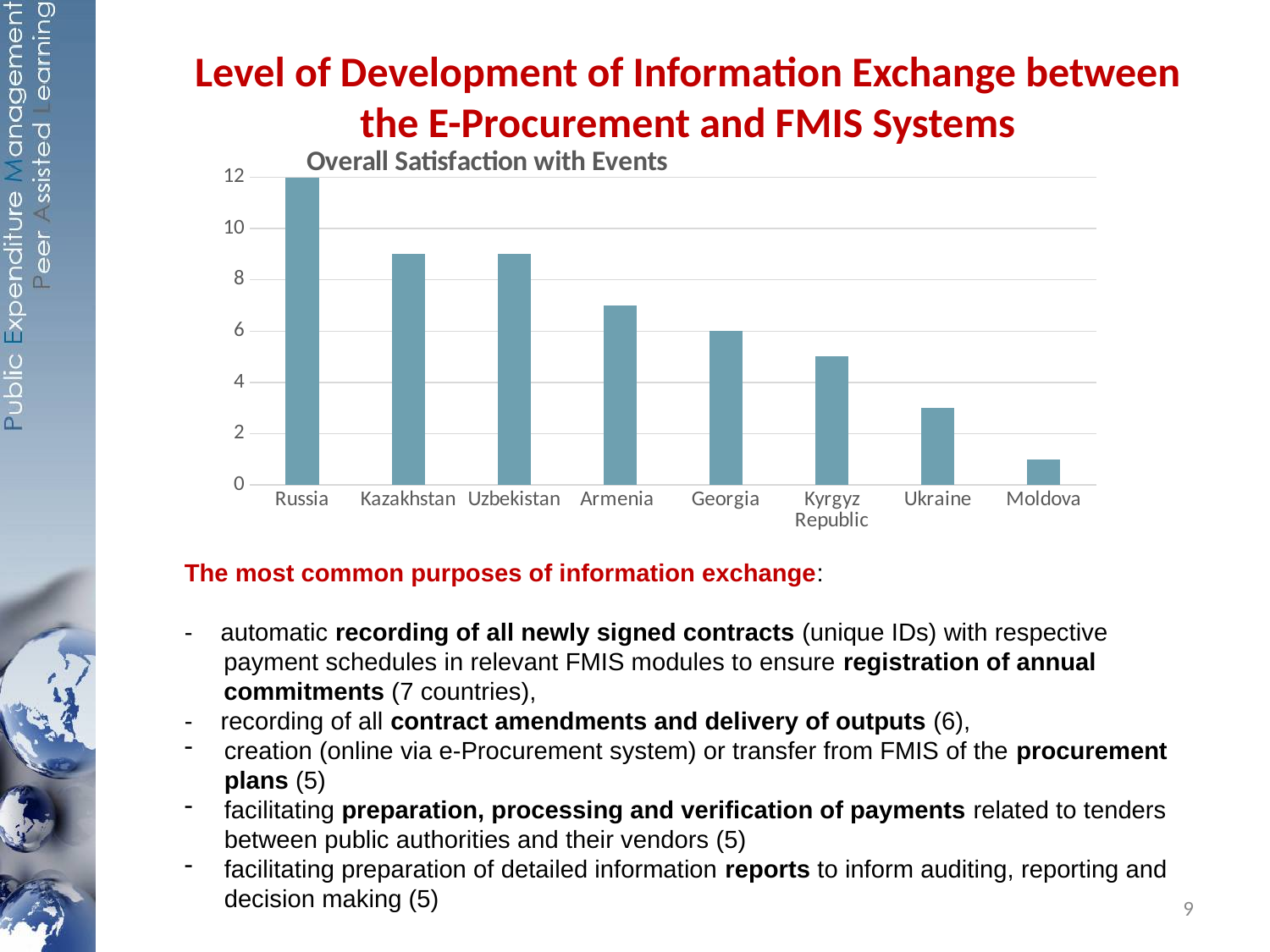
Which has a larger value, Armenia or Ukraine? Armenia What is the title of the chart? Overall Satisfaction with Events Is the value for Ukraine greater or less than 4? less What is the value for Russia? 12 Do the values rise or fall moving from left to right along the x axis? fall What is the value for Georgia? 6 How many countries are shown on the x axis of the chart? 8 What is the difference between the values for Russia and Georgia? 6 Is the value for Kazakhstan greater or less than 8? greater Which country has the highest value in the chart? Russia What type of chart is shown on the slide? bar chart Which country has the lowest value in the chart? Moldova